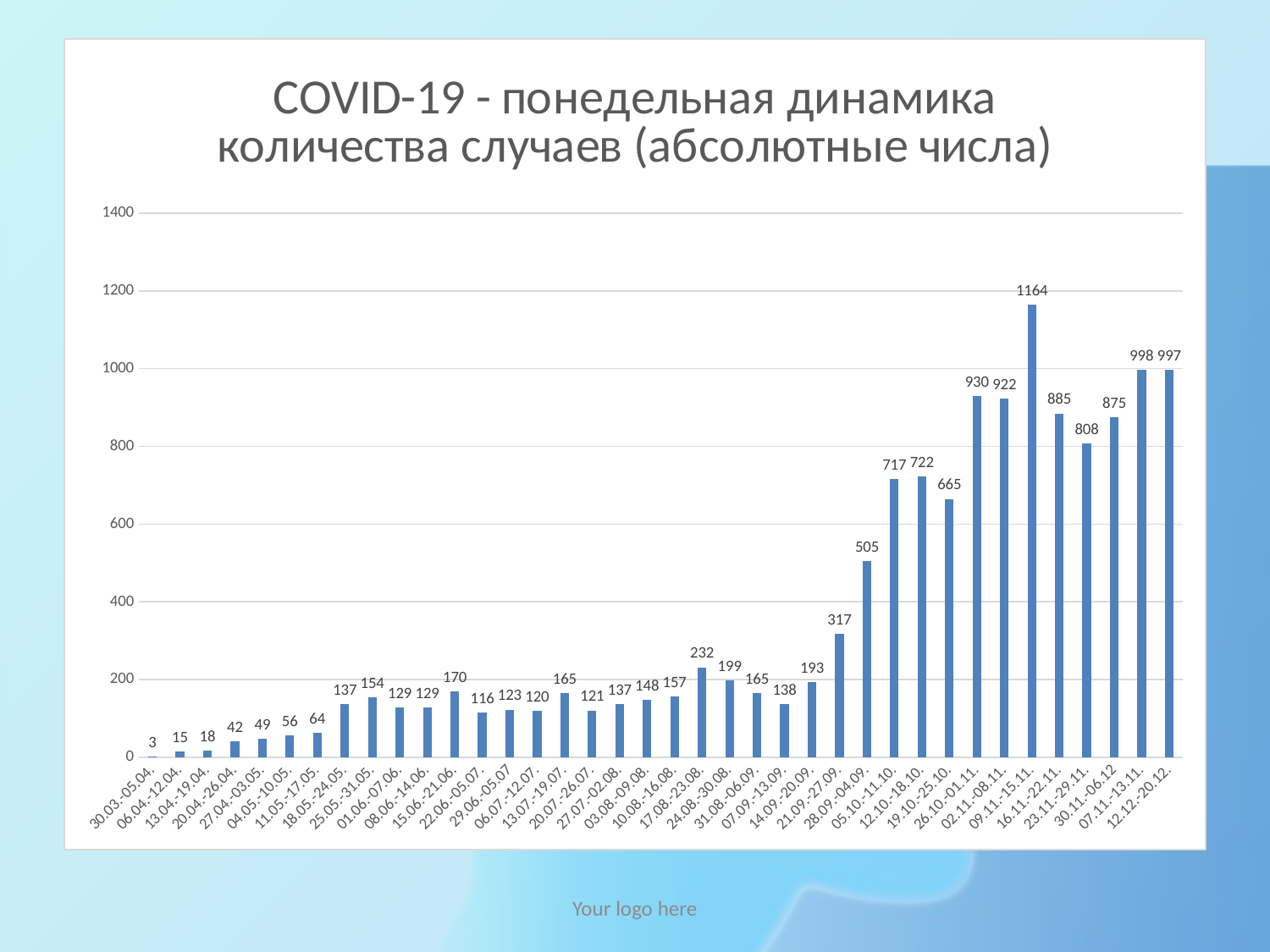
Which week has the lowest number of cases? 30.03.-05.04. Which is larger, the value for 26.10.-01.11. or the value for 02.11.-08.11.? 26.10.-01.11. Is the value for 21.09.-27.09. greater or less than 400? less What is the title of the chart? COVID-19 - понедельная динамика количества случаев (абсолютные числа) What is the difference between the values for 09.11.-15.11. and 16.11.-22.11.? 279 How many weekly bars are plotted on the chart? 38 What is the value for the week 17.08.-23.08.? 232 What is the value for the week 09.11.-15.11.? 1164 What kind of chart is shown on the slide? bar chart Which week has the highest number of cases? 09.11.-15.11. Do the values generally rise or fall from 21.09.-27.09. to 09.11.-15.11.? rise What is the value for the week 28.09.-04.09.? 505